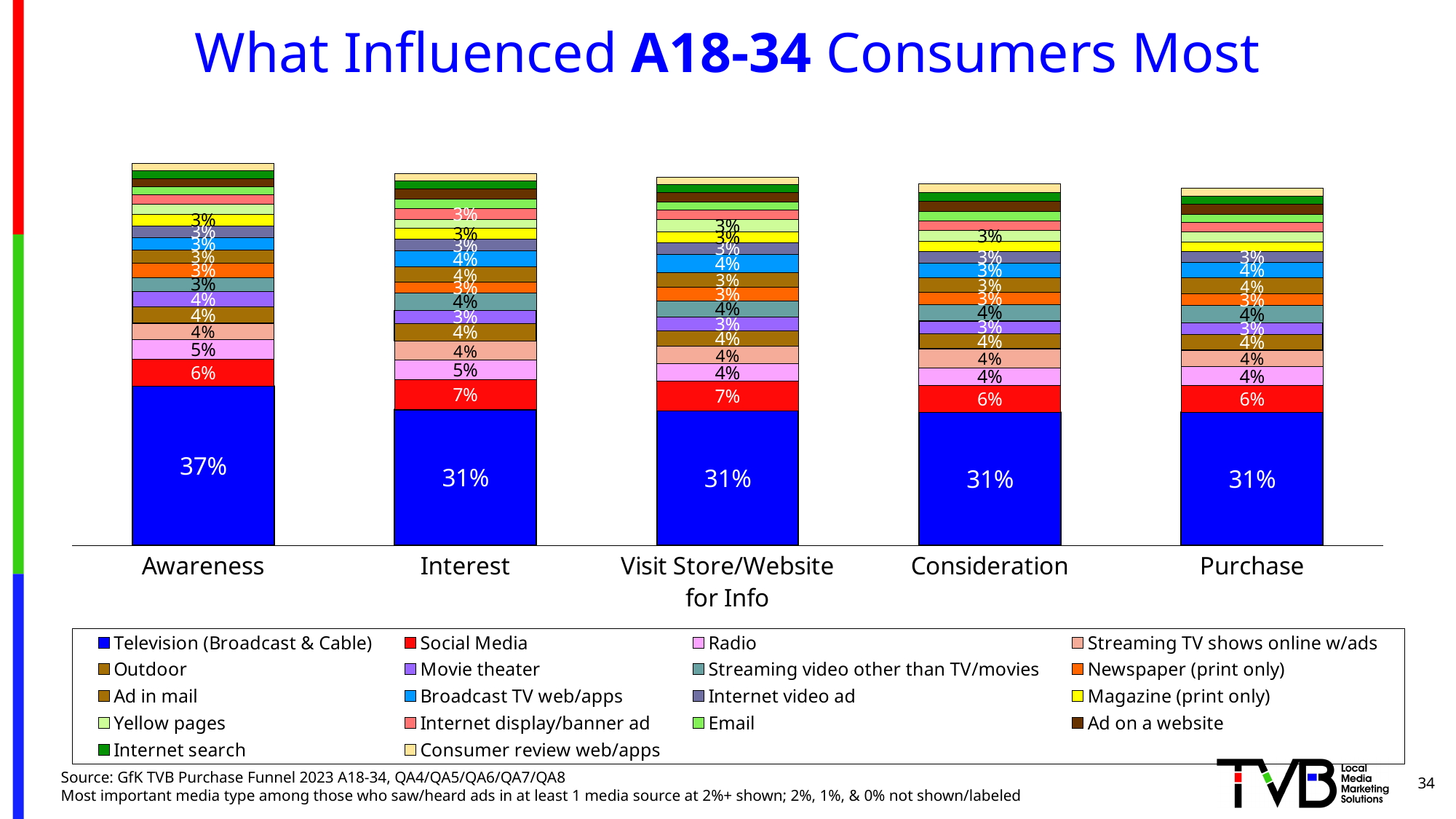
What is the value for Social Media in the Interest bar? 7% How many categories are shown along the x axis? 5 How many series does the legend list? 18 What is the title of the chart? What Influenced A18-34 Consumers Most What kind of chart is shown on the slide? Stacked bar chart In which category is the Television (Broadcast & Cable) value highest? Awareness Does the Television (Broadcast & Cable) value rise or fall from Awareness to Interest? Fall What is the value for Radio in the Awareness bar? 5% What is the difference between the Television (Broadcast & Cable) values for Awareness and Interest? 6 percentage points Which is larger: the Social Media value for Awareness or for Interest? Interest What is the value for Social Media in the Purchase bar? 6% What is the value for Television (Broadcast & Cable) in the Awareness bar? 37%